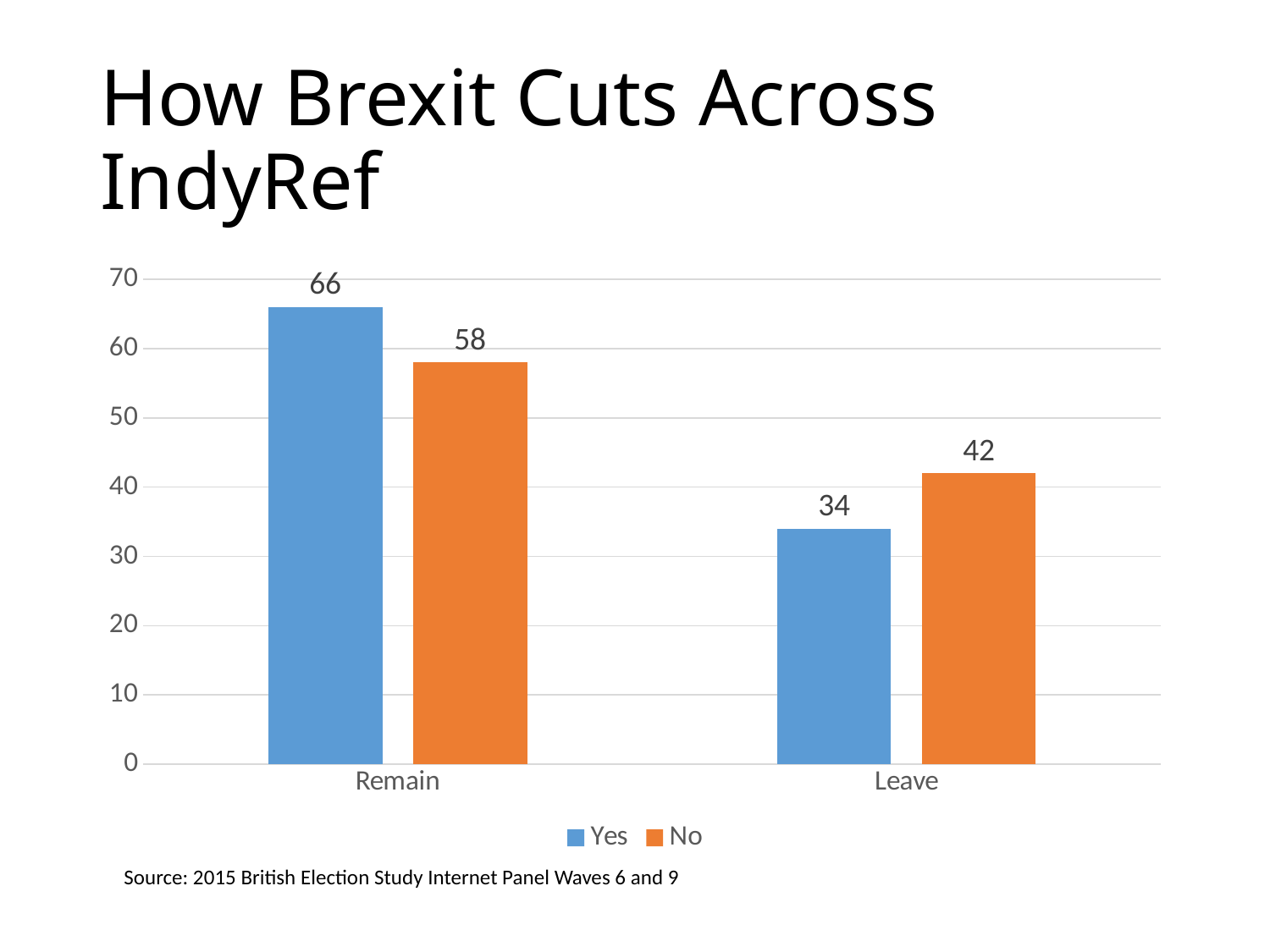
How many categories are shown on the x axis? 2 What colour represents the No series? Orange What kind of chart is shown on the slide? Bar chart Which category has the highest value for the No series? Remain What is the value for No in the Leave category? 42 How many series does the legend list? 2 What is the value for Yes in the Leave category? 34 What is the value for Yes in the Remain category? 66 Which category has the lowest value for the Yes series? Leave In the Leave category, which is larger, Yes or No? No What is the difference between the Yes values for Remain and Leave? 32 What is the difference between the Yes and No values in the Remain category? 8